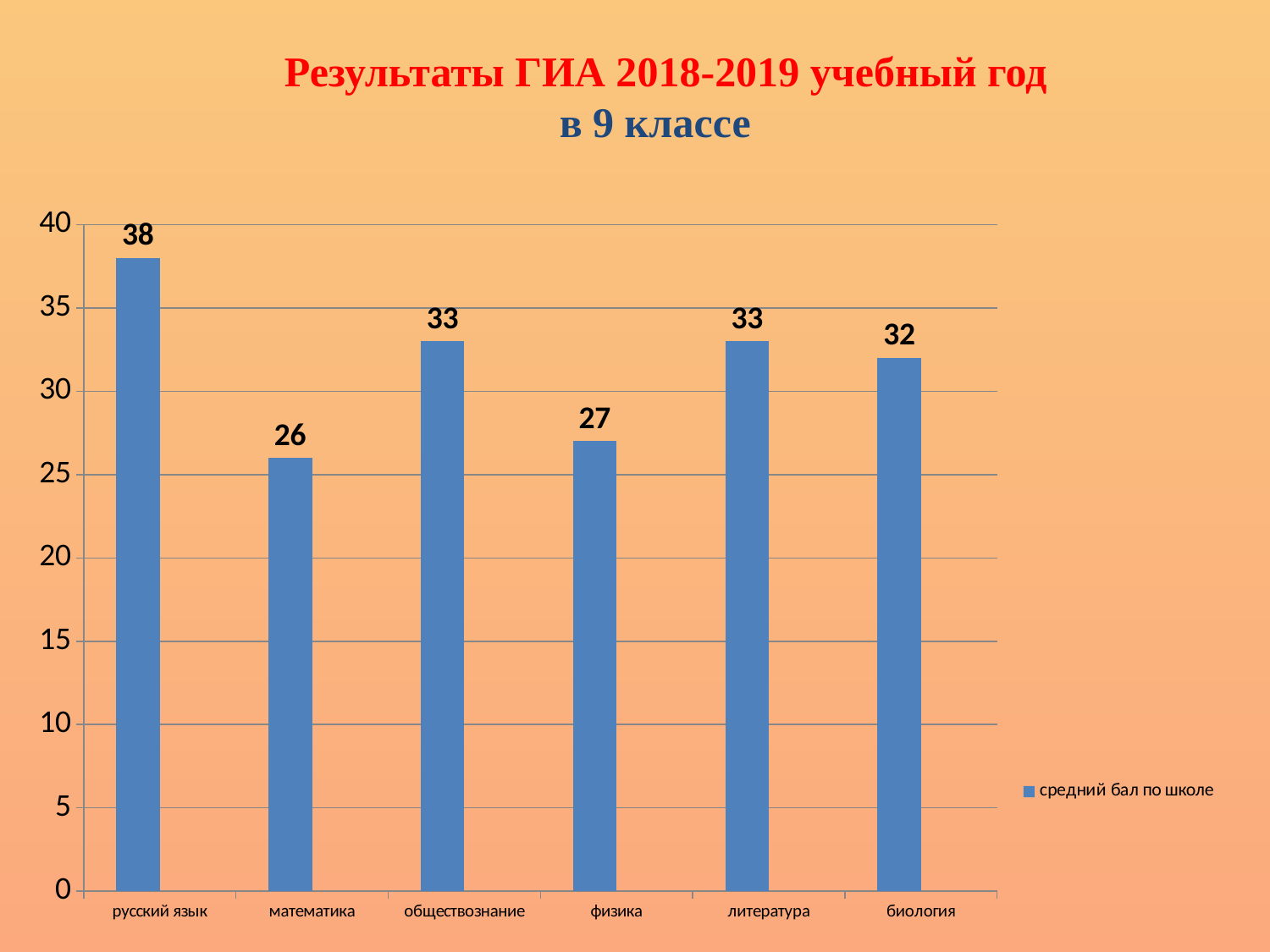
Which category has the highest value? русский язык What is the value for биология? 32 Which is larger, the value for обществознание or the value for биология? обществознание What kind of chart is shown on the slide? bar chart What is the value for физика? 27 How many categories are shown on the x axis? 6 Which category has the lowest value? математика What is the value for математика? 26 What is the legend entry for the series shown? средний бал по школе What is the difference between the values for русский язык and математика? 12 Is the value for физика greater or less than 30? less What is the value for русский язык? 38